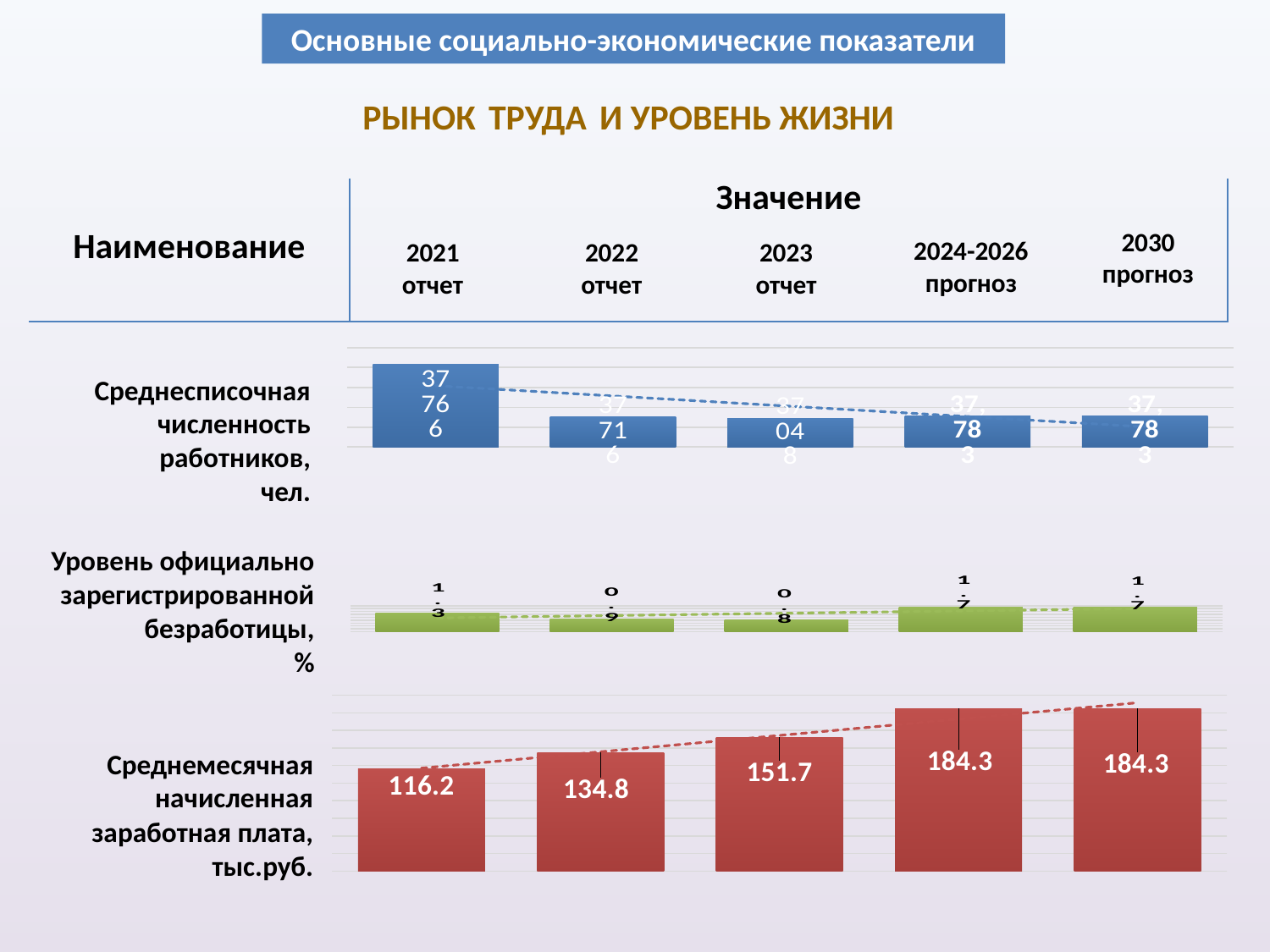
In the chart for Среднемесячная начисленная заработная плата, тыс.руб., what is the value for the 2024-2026 прогноз? 184.3 What kind of chart is used for Среднесписочная численность работников, чел.? bar chart In the chart for Среднемесячная начисленная заработная плата, тыс.руб., do the values rise or fall from 2021 to 2030? rise In the chart for Среднемесячная начисленная заработная плата, тыс.руб., what is the difference between the 2023 отчет and 2022 отчет values? 16.9 In the chart for Среднемесячная начисленная заработная плата, тыс.руб., what is the value for 2023 отчет? 151.7 In the chart for Среднемесячная начисленная заработная плата, тыс.руб., which period has the lowest value? 2021 отчет In the chart for Уровень официально зарегистрированной безработицы, %, which is larger: the value for 2021 отчет or 2022 отчет? 2021 отчет In the chart for Уровень официально зарегистрированной безработицы, %, what is the value for 2023 отчет? 0.8 In the chart for Среднесписочная численность работников, чел., which is larger: the value for 2021 отчет or 2023 отчет? 2021 отчет In the chart for Среднемесячная начисленная заработная плата, тыс.руб., what is the value for 2021 отчет? 116.2 How many bars are in the chart for Среднемесячная начисленная заработная плата, тыс.руб.? 5 In the chart for Уровень официально зарегистрированной безработицы, %, which period has the lowest value? 2023 отчет